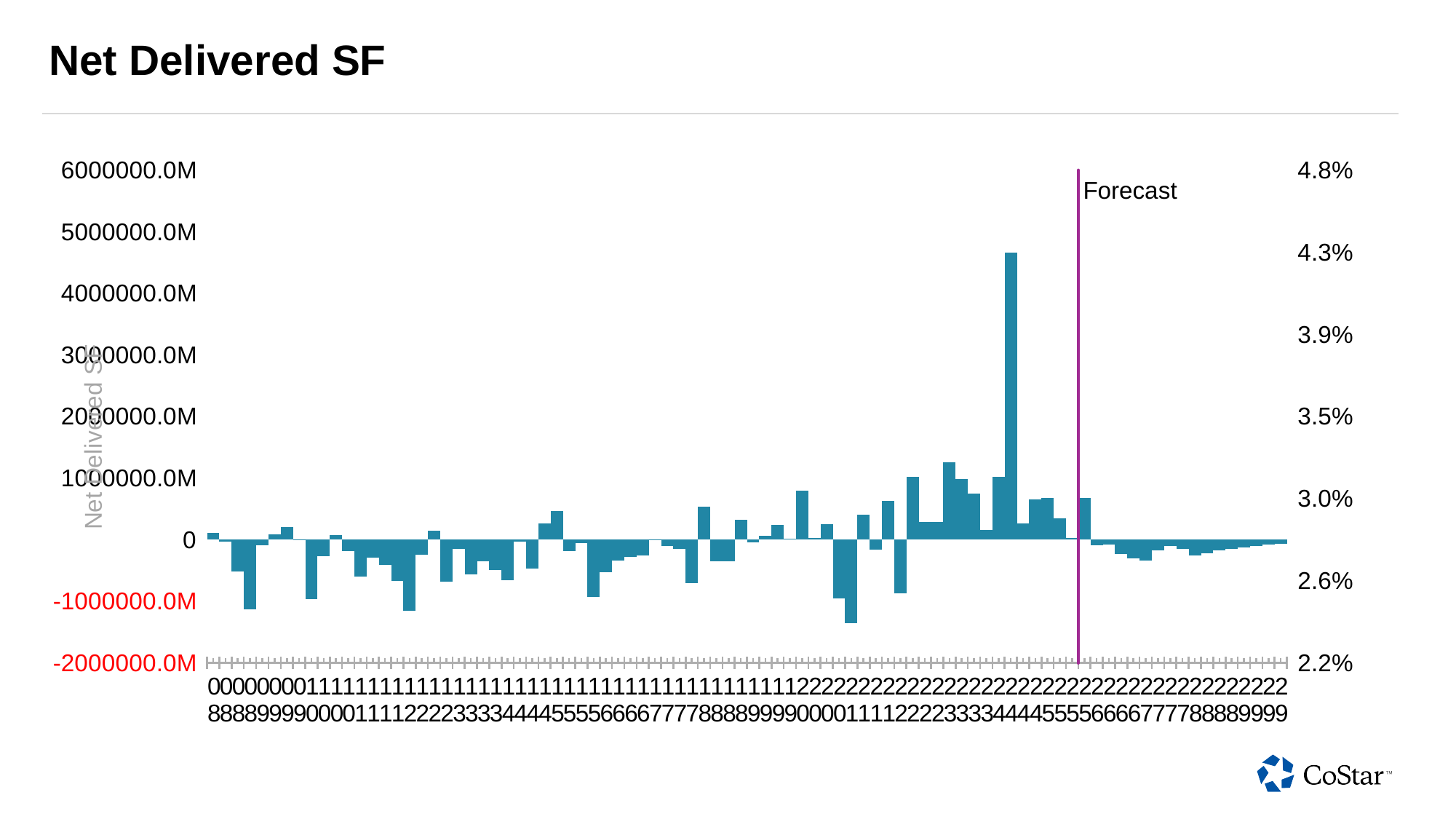
What label is written next to the vertical line on the chart? Forecast What kind of chart is shown on the slide? bar chart Do any of the bars to the right of the Forecast line reach above 1000000.0M? No Does the chart contain bars with negative values? Yes What is the title of the chart? Net Delivered SF Is the value of the tallest bar greater or less than 4000000.0M? greater